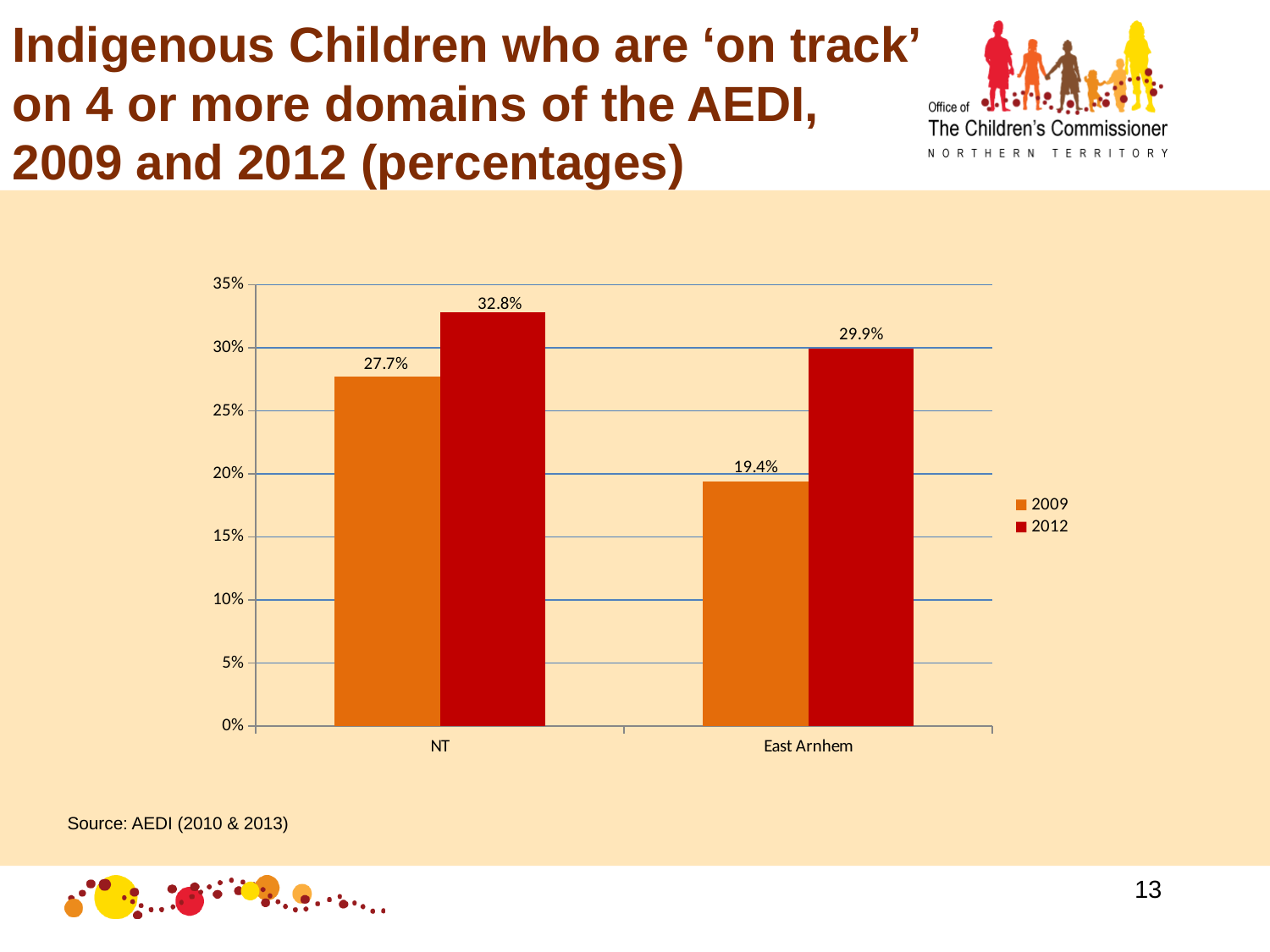
What is the 2012 value for East Arnhem? 29.9% How many series does the legend list? 2 What is the difference between the 2012 values for NT and East Arnhem? 2.9% Is the 2009 value for East Arnhem greater or less than 20%? less How many categories are shown on the x axis? 2 Which is larger: the 2009 value for NT or the 2012 value for East Arnhem? 2012 value for East Arnhem What kind of chart is shown on the slide? bar chart What is the 2009 value for NT? 27.7% What is the 2009 value for East Arnhem? 19.4% What is the difference between the 2012 and 2009 values for East Arnhem? 10.5% Which category has the highest 2012 value? NT Which category has the lowest 2009 value? East Arnhem